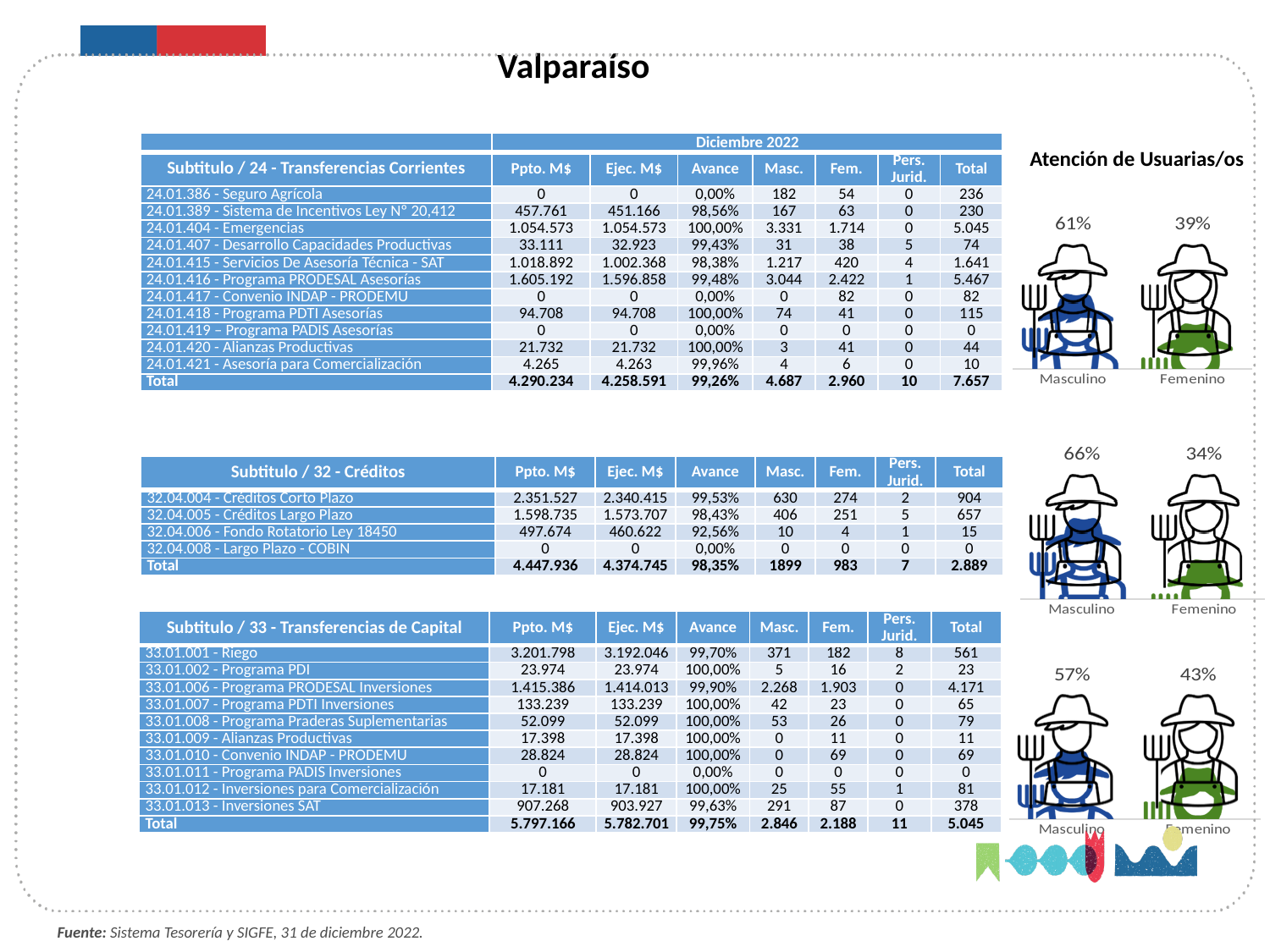
In the middle pictogram chart on the right side of the slide, what is the difference between the Masculino and Femenino percentages? 32% In the middle pictogram chart on the right side of the slide, what percentage is shown for Femenino? 34% What is the title above the pictogram charts on the right side of the slide? Atención de Usuarias/os In the top 'Atención de Usuarias/os' pictogram chart, what percentage is shown for Masculino? 61% Across the three pictogram charts on the right side of the slide, which chart shows the highest Masculino percentage? The middle chart (66%) How many categories does each pictogram chart on the right side of the slide show? 2 In the bottom pictogram chart on the right side of the slide, what percentage is shown for Masculino? 57% In the top 'Atención de Usuarias/os' pictogram chart, what percentage is shown for Femenino? 39% In the bottom pictogram chart on the right side of the slide, what is the difference between the Masculino and Femenino percentages? 14% In the top 'Atención de Usuarias/os' pictogram chart, which category has the higher percentage, Masculino or Femenino? Masculino In the middle pictogram chart on the right side of the slide, what percentage is shown for Masculino? 66% In the bottom pictogram chart on the right side of the slide, what percentage is shown for Femenino? 43%